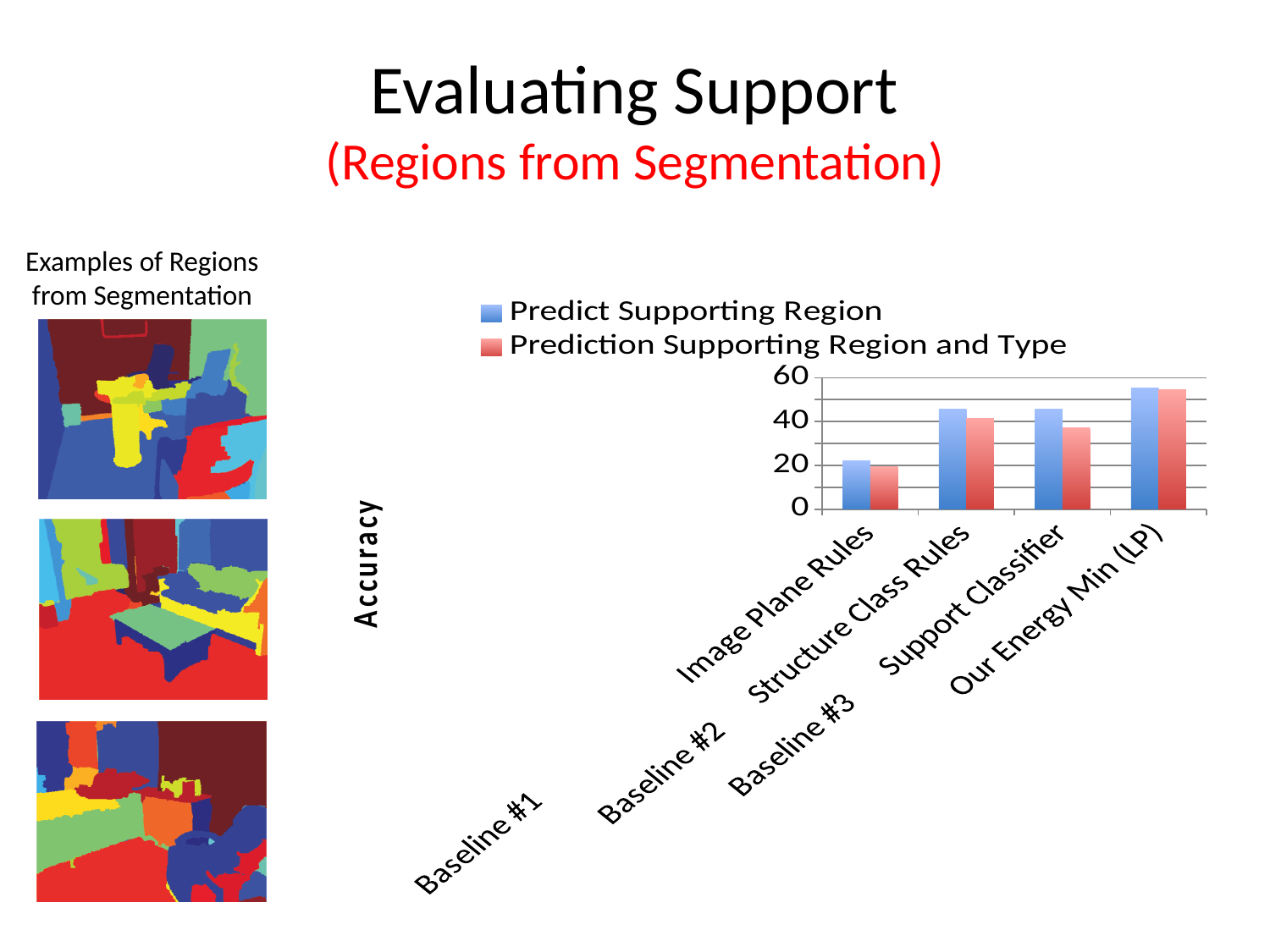
Is the Prediction Supporting Region and Type value for Support Classifier greater or less than 40? less How many categories are shown on the x axis of the chart? 4 How many series does the chart legend list? 2 Which category has the highest value for Predict Supporting Region? Our Energy Min (LP) Which category has the lowest value for Prediction Supporting Region and Type? Image Plane Rules Is the Predict Supporting Region value for Structure Class Rules greater or less than 40? greater Which series is shown in red in the chart? Prediction Supporting Region and Type Is the Predict Supporting Region value for Our Energy Min (LP) greater or less than 40? greater What kind of chart is shown on the slide? bar chart What is the label on the vertical axis of the chart? Accuracy For Support Classifier, which series has the larger value: Predict Supporting Region or Prediction Supporting Region and Type? Predict Supporting Region